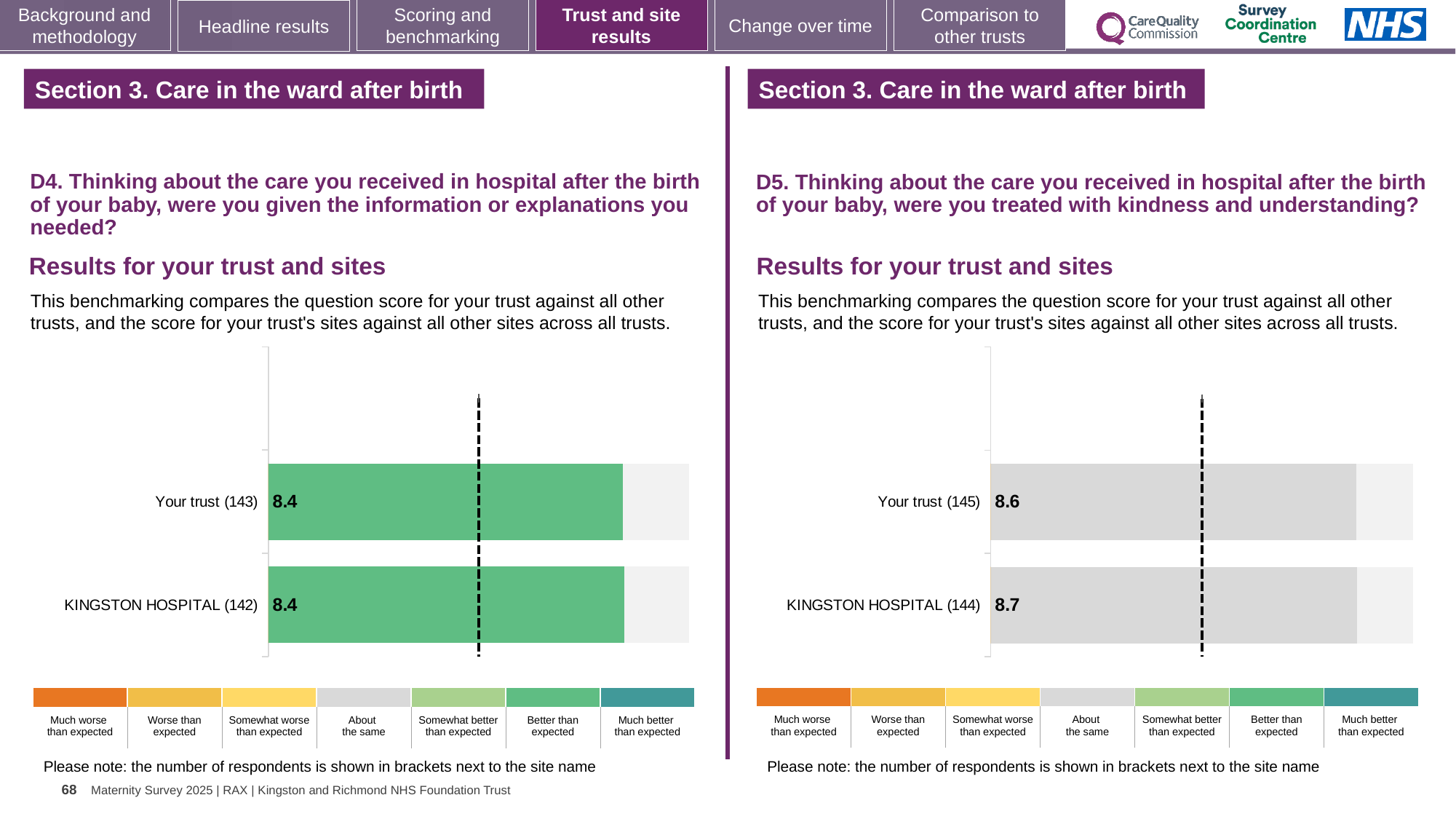
In the D4 chart on the left, what is the score for Your trust? 8.4 In the D4 chart on the left, what is the score for KINGSTON HOSPITAL? 8.4 In the D5 chart on the right, what is the score for Your trust? 8.6 How many bars are plotted in the D4 chart on the left? 2 In the D5 chart on the right, which has the higher score, Your trust or KINGSTON HOSPITAL? KINGSTON HOSPITAL In the D5 chart on the right, what is the score for KINGSTON HOSPITAL? 8.7 In the D4 chart on the left, how many respondents are shown in brackets for Your trust? 143 In the D5 chart on the right, how many respondents are shown in brackets for KINGSTON HOSPITAL? 144 In the D5 chart on the right, what is the difference between the KINGSTON HOSPITAL score and the Your trust score? 0.1 According to the colour key, which benchmarking category do the green bars in the D4 chart on the left represent? Better than expected In the D4 chart on the left, what is the difference between the Your trust score and the KINGSTON HOSPITAL score? 0 What kind of chart is used for the D5 results on the right? Bar chart